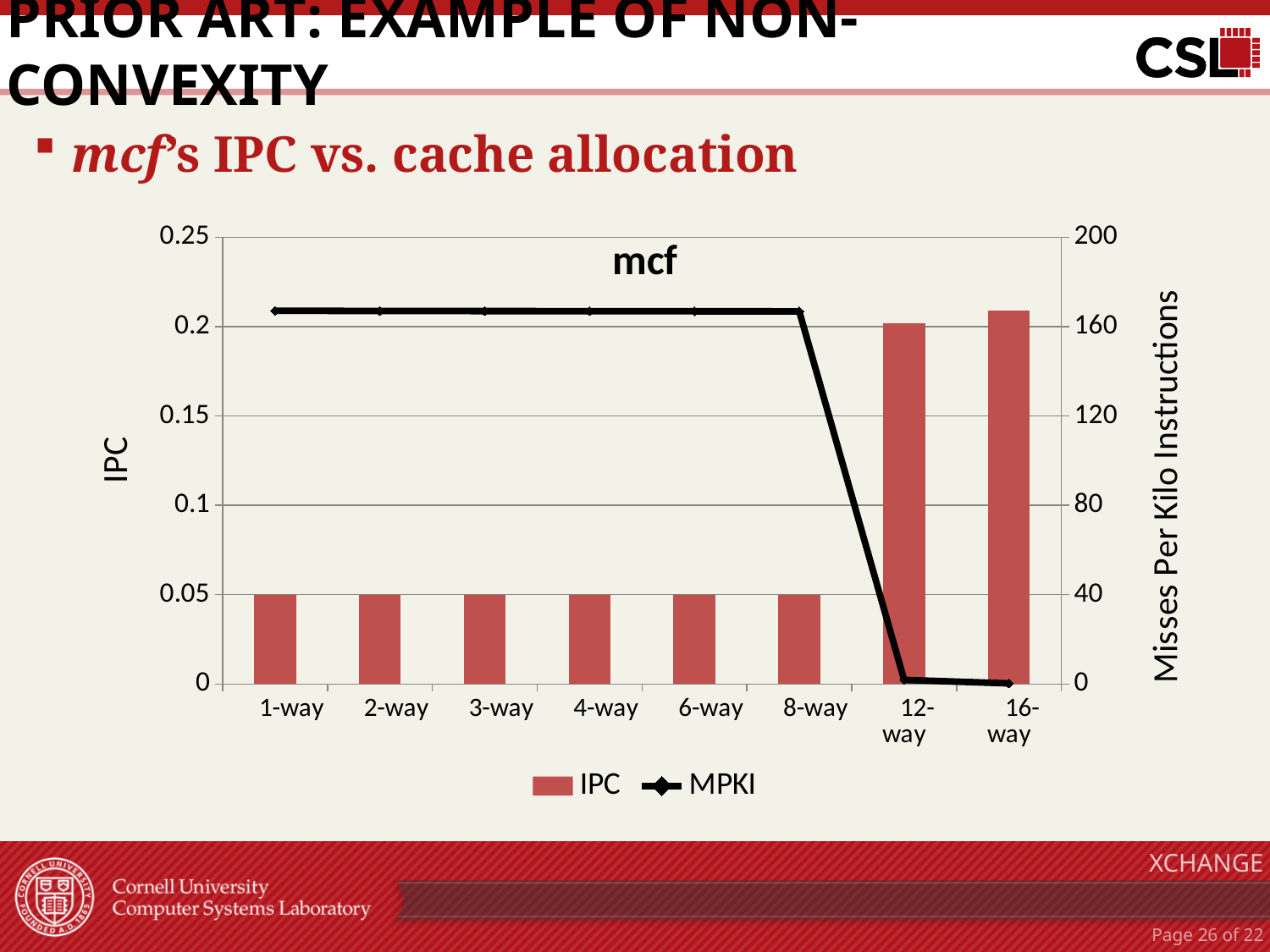
What is the label of the right-hand vertical axis of the mcf chart? Misses Per Kilo Instructions Is the MPKI value for 16-way greater or less than 40? less Which has the higher MPKI, 8-way or 12-way? 8-way Does the MPKI line rise or fall as the cache allocation increases from 1-way to 16-way? It falls How many cache allocation categories are shown on the x axis of the mcf chart? 8 Which has the higher IPC, 1-way or 16-way? 16-way How many series does the legend of the mcf chart list? 2 What are the two series named in the legend of the mcf chart? IPC and MPKI Is the IPC value for 12-way greater or less than 0.15? greater What is the IPC value for 1-way in the mcf chart? 0.05 Is the MPKI value for 4-way greater or less than 120? greater What kind of chart is shown on the slide? A combined bar and line chart